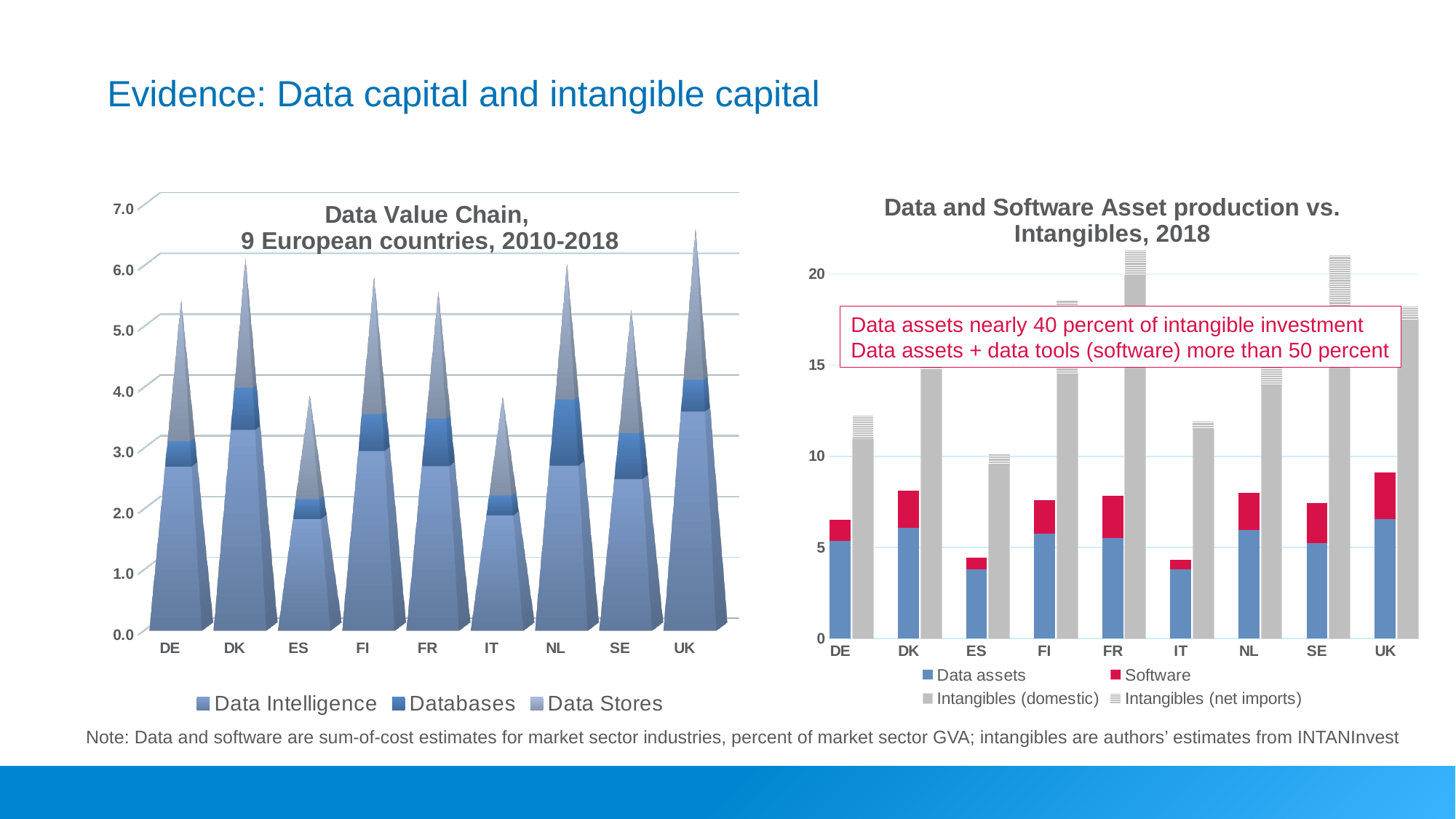
How many series does the legend of the 'Data and Software Asset production vs. Intangibles, 2018' chart list? 4 In the 'Data and Software Asset production vs. Intangibles, 2018' chart, is the Intangibles (domestic) value for FR greater or less than 15? greater In the 'Data Value Chain' chart, is the total value for DE greater or less than 5.0? greater How many series does the legend of the 'Data Value Chain' chart list? 3 In the 'Data and Software Asset production vs. Intangibles, 2018' chart, which is larger: the Data assets value for DK or for ES? DK What colour represents Software in the 'Data and Software Asset production vs. Intangibles, 2018' chart? red What kind of chart is the left chart titled 'Data Value Chain, 9 European countries, 2010-2018'? bar chart In the 'Data and Software Asset production vs. Intangibles, 2018' chart, which country has the lowest Intangibles (domestic) value? ES In the 'Data Value Chain' chart, which country has the tallest bar? UK In the 'Data Value Chain' chart, is the total value for ES greater or less than 5.0? less In the 'Data and Software Asset production vs. Intangibles, 2018' chart, which country has the highest Data assets value? UK How many countries are shown on the x axis of the 'Data Value Chain' chart? 9